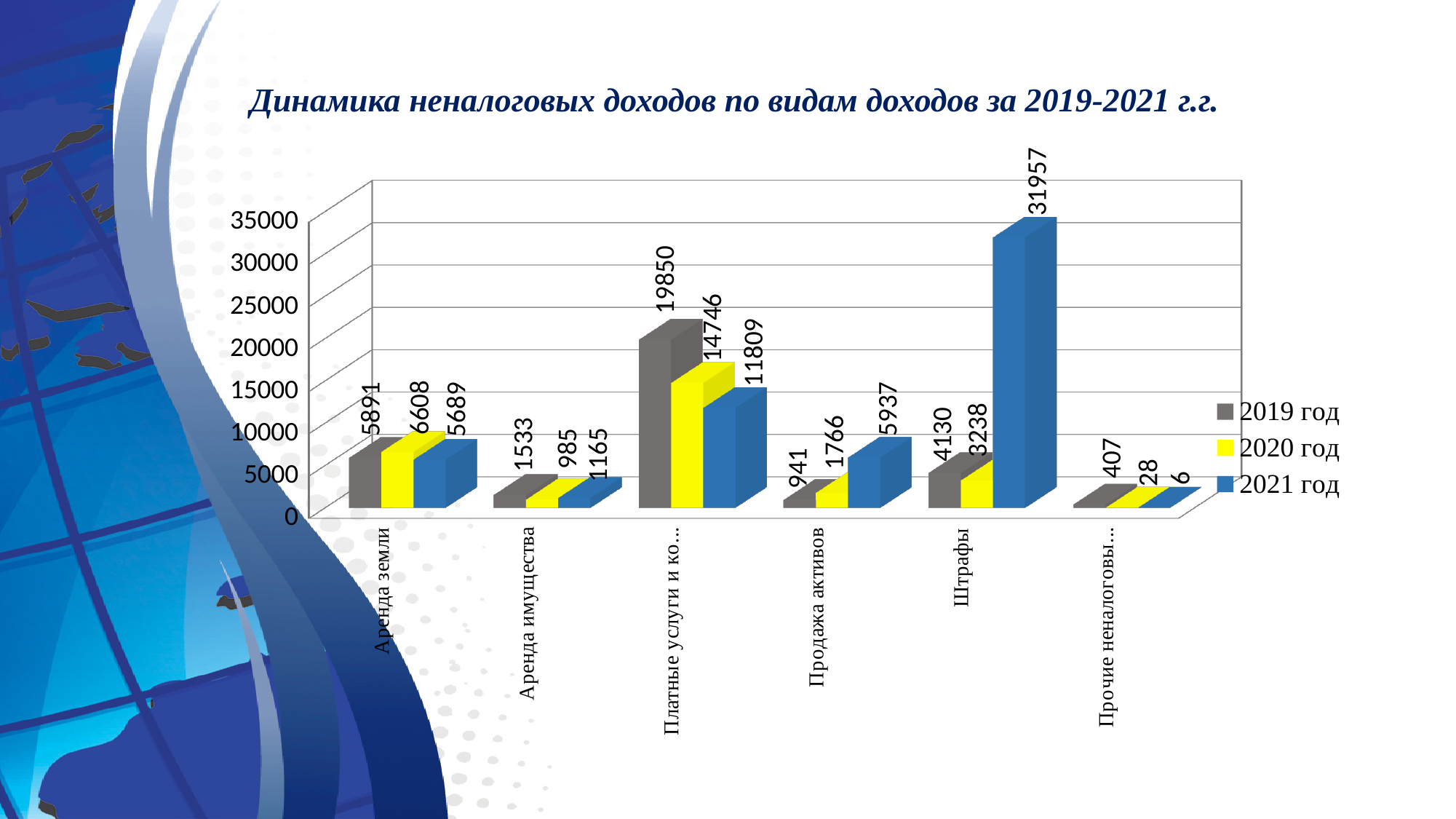
Which category has the lowest value in the 2019 год series? Прочие неналоговы... How many series does the legend list? 3 What is the value for Продажа активов in 2019 год? 941 What kind of chart is shown on the slide? Bar chart How many categories are shown on the x axis? 6 What is the title of the chart? Динамика неналоговых доходов по видам доходов за 2019-2021 г.г. What is the value for Аренда имущества in 2021 год? 1165 Which category has the highest value in the 2021 год series? Штрафы What is the value for Штрафы in 2021 год? 31957 Which is larger for Продажа активов: the 2020 год value or the 2021 год value? 2021 год What is the difference between the 2019 год and 2020 год values for Штрафы? 892 What is the value for Аренда земли in 2020 год? 6608